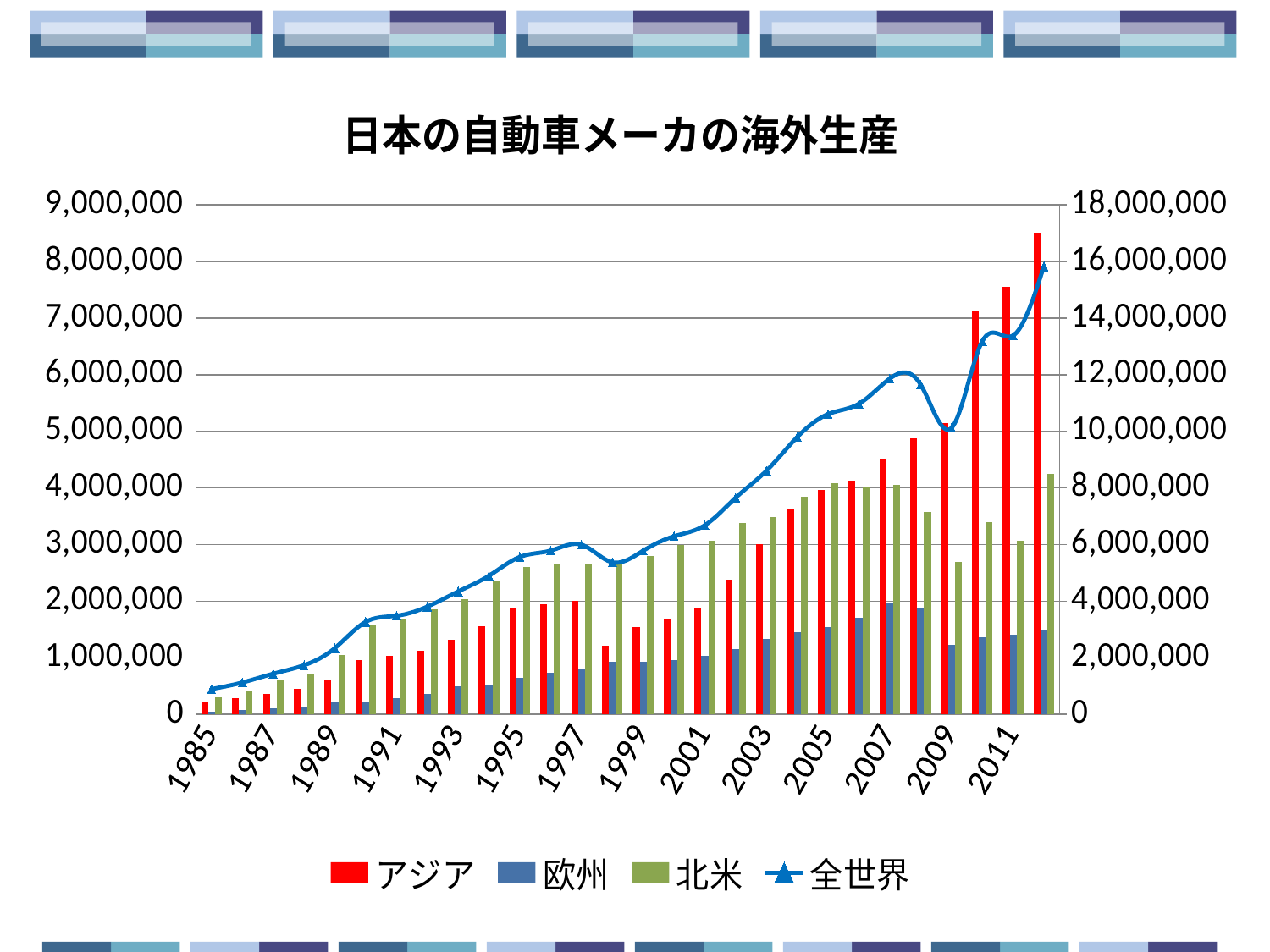
In which year is the アジア bar lowest? 1985 Does the 全世界 line generally rise or fall from 1985 to 2012? rise Which series is plotted as a line with triangle markers? 全世界 What is the title of the chart? 日本の自動車メーカの海外生産 Which is larger in 1995, アジア or 北米? 北米 How many series does the legend list? 4 In which year is the アジア bar highest? 2012 Is the value for 全世界 in 1985 greater or less than 2,000,000 on the right axis? less Is the value for 欧州 in 2012 greater or less than 2,000,000? less Is the value for アジア in 2012 greater or less than 8,000,000? greater What kind of chart is shown on the slide? A combined bar and line chart Which is larger in 2012, アジア or 北米? アジア